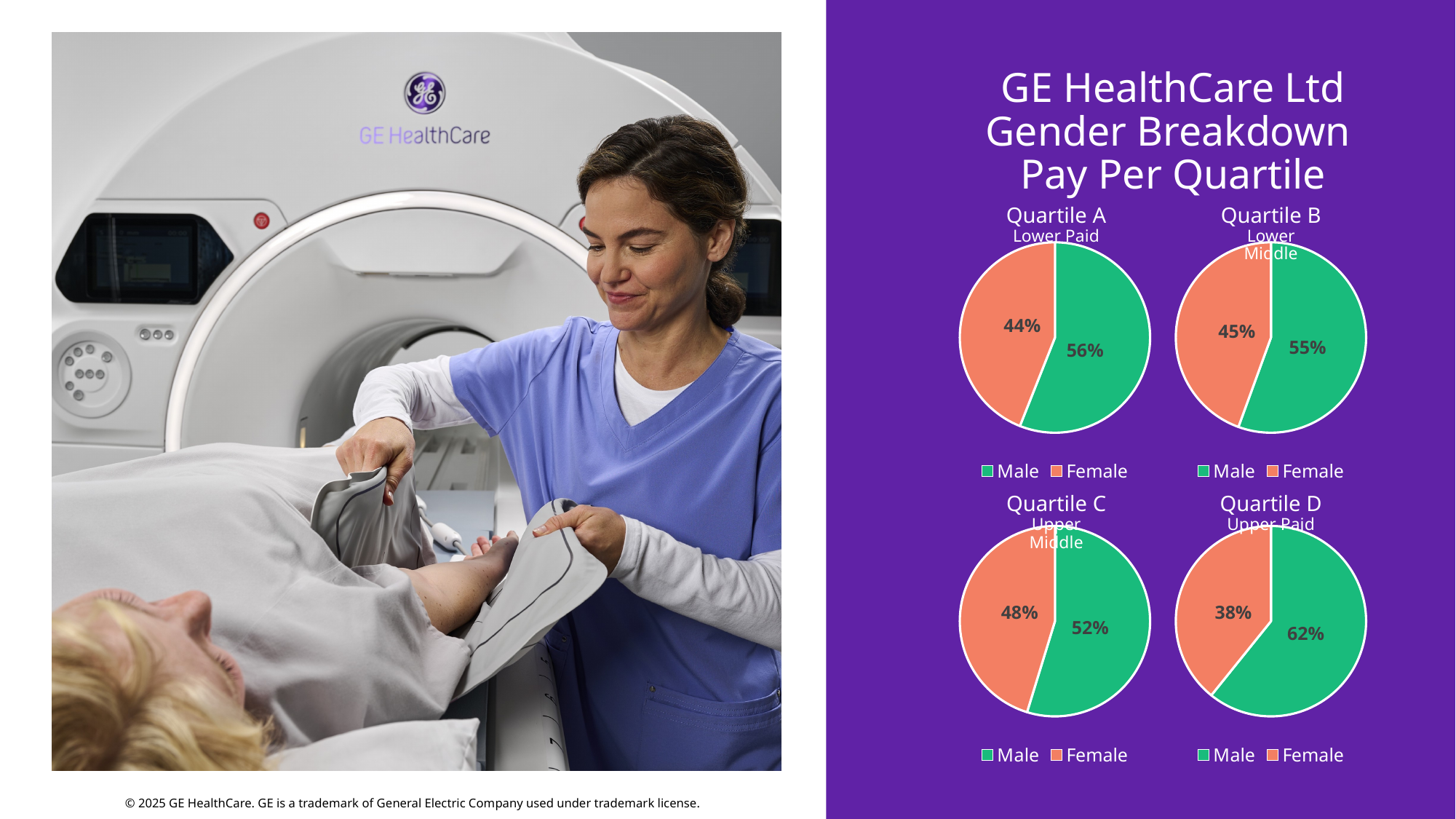
In the Quartile A (Lower Paid) pie chart, what percentage is Female? 44% In the Quartile D (Upper Paid) pie chart, what colour represents Female? Orange How many slices does the Quartile B (Lower Middle) pie chart have? 2 What type of chart is used for Quartile A (Lower Paid)? Pie chart In the Quartile D (Upper Paid) pie chart, what is the difference between the Male and Female percentages? 24% In the Quartile D (Upper Paid) pie chart, what percentage is Female? 38% Across the four pie charts, which quartile has the highest Male percentage? Quartile D In the Quartile C (Upper Middle) pie chart, what percentage is Male? 52% Across the four pie charts, which quartile has the lowest Female percentage? Quartile D In the Quartile B (Lower Middle) pie chart, what percentage is Female? 45% In the Quartile A (Lower Paid) pie chart, what percentage is Male? 56% In the Quartile C (Upper Middle) pie chart, which is larger, Male or Female? Male